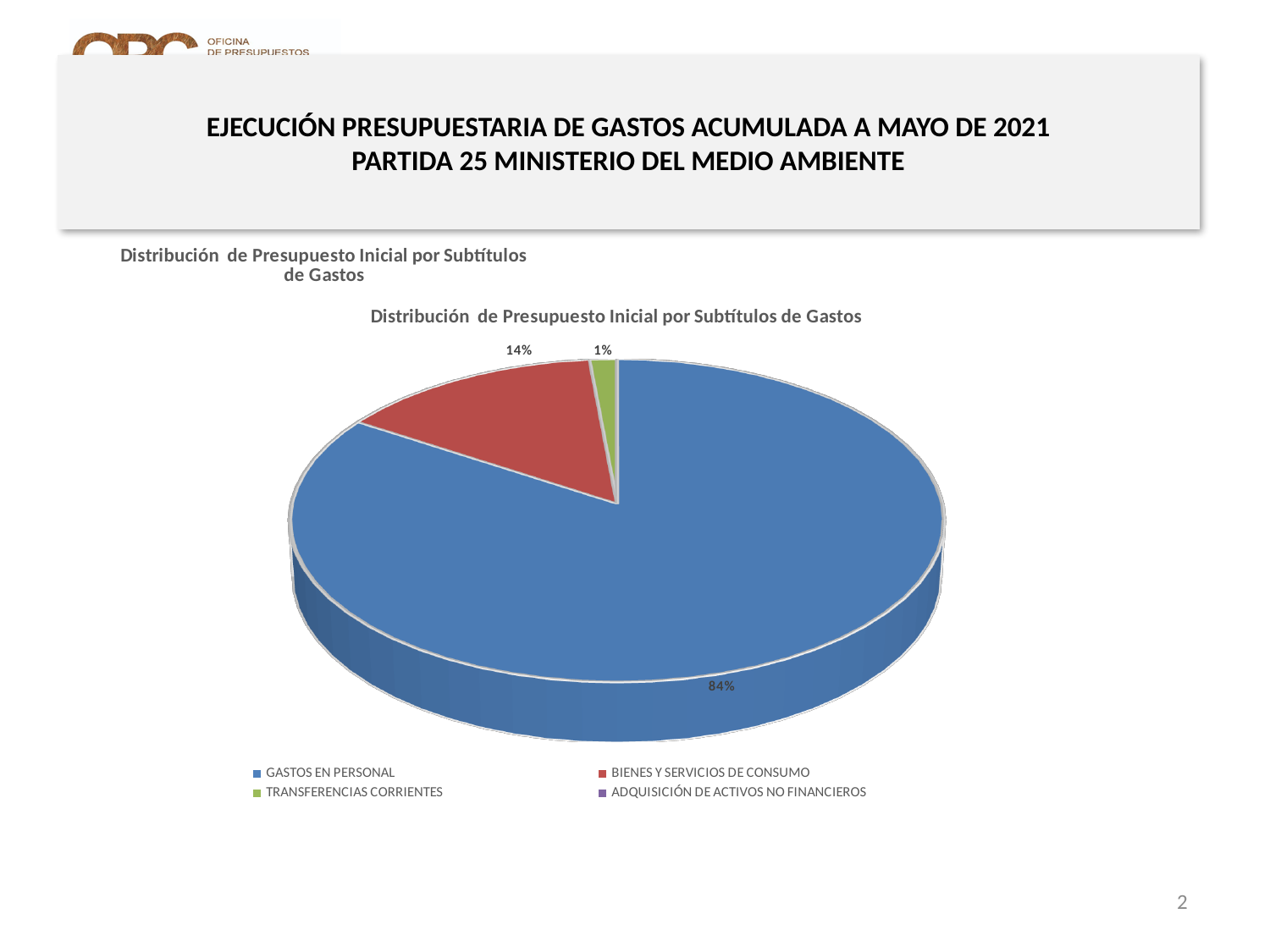
Which category has the largest slice of the pie? GASTOS EN PERSONAL What colour is the slice for GASTOS EN PERSONAL? blue What share of the pie does TRANSFERENCIAS CORRIENTES represent? 1% How many categories does the legend of the pie chart list? 4 What is the title of the pie chart? Distribución de Presupuesto Inicial por Subtítulos de Gastos What kind of chart is shown on the slide? pie chart Which is larger, the slice for BIENES Y SERVICIOS DE CONSUMO or the slice for TRANSFERENCIAS CORRIENTES? BIENES Y SERVICIOS DE CONSUMO What share of the pie does GASTOS EN PERSONAL represent? 84% By how many percentage points does the GASTOS EN PERSONAL share exceed the BIENES Y SERVICIOS DE CONSUMO share? 70 percentage points What share of the pie does BIENES Y SERVICIOS DE CONSUMO represent? 14%